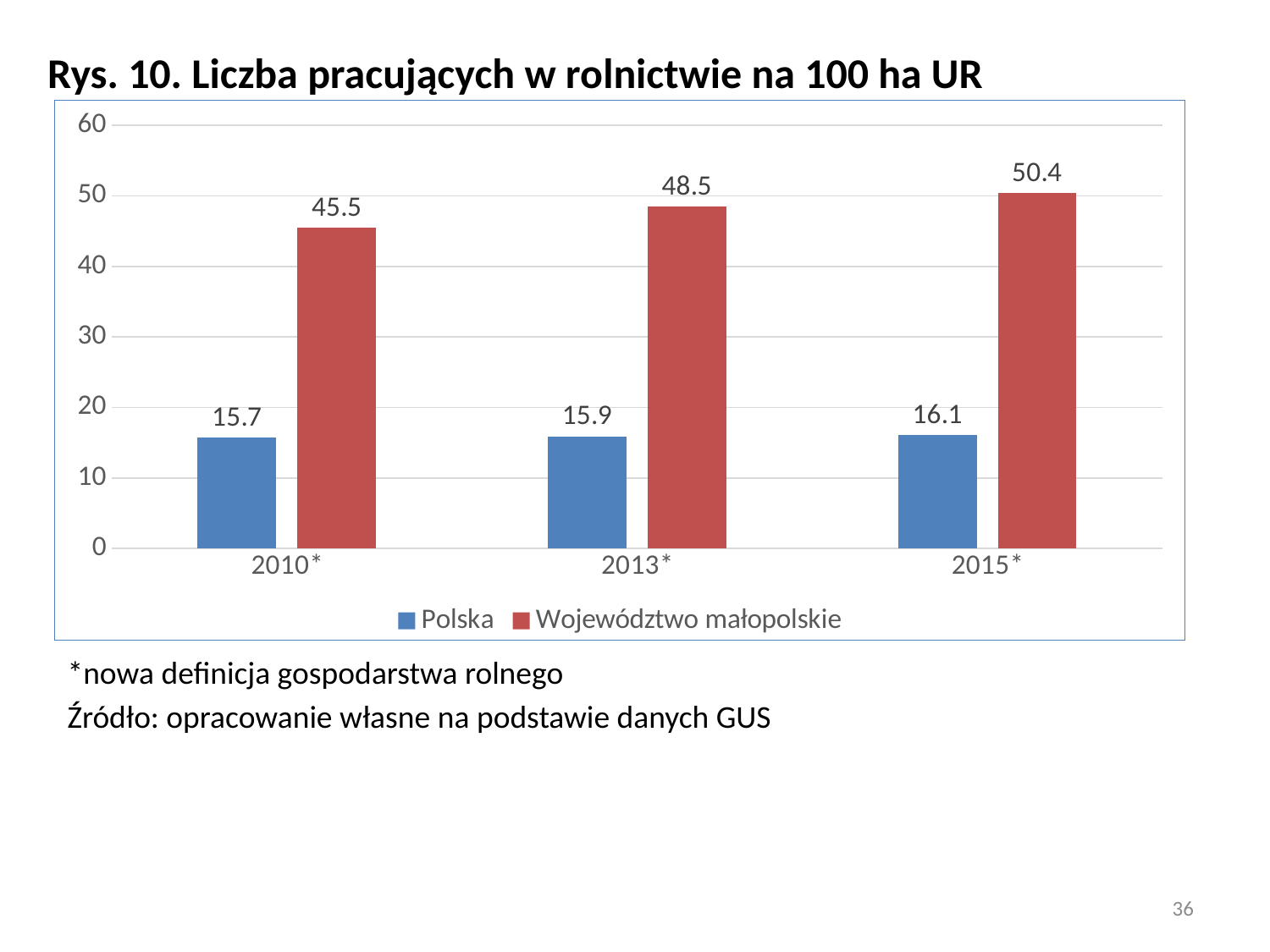
In which year is the value for Polska lowest? 2010* How many series does the legend list? 2 Do the values for Województwo małopolskie rise or fall from 2010* to 2015*? rise What is the value for Polska in 2010*? 15.7 What is the difference between the Województwo małopolskie values in 2013* and 2010*? 3 What is the value for Województwo małopolskie in 2013*? 48.5 How many years are shown on the x axis? 3 In which year is the value for Województwo małopolskie highest? 2015* What is the difference between Województwo małopolskie and Polska in 2015*? 34.3 What is the value for Województwo małopolskie in 2015*? 50.4 What kind of chart is shown? bar chart Which is larger in 2013*: Polska or Województwo małopolskie? Województwo małopolskie